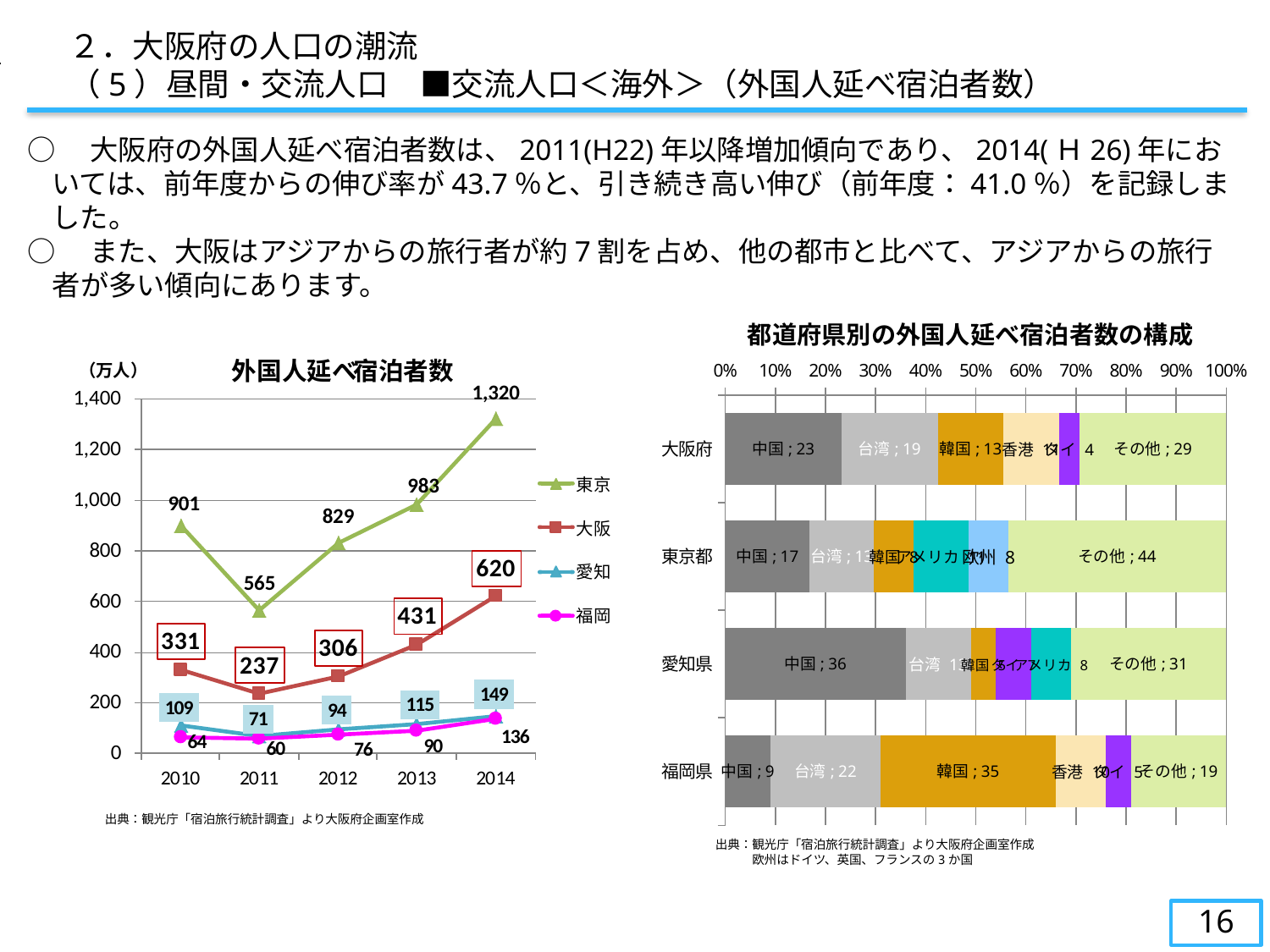
In the chart titled 外国人延べ宿泊者数, how many series does the legend list? 4 In the chart titled 外国人延べ宿泊者数, in which year is the value for 大阪 lowest? 2011 In the chart titled 都道府県別の外国人延べ宿泊者数の構成, how many prefectures are shown? 4 In the chart titled 外国人延べ宿泊者数, what is the value for 福岡 in 2014? 136 In the chart titled 外国人延べ宿泊者数, which is larger in 2012: the value for 愛知 or the value for 福岡? 愛知 In the chart titled 外国人延べ宿泊者数, does the value for 大阪 rise or fall from 2011 to 2014? rise In the chart titled 外国人延べ宿泊者数, what is the value for 大阪 in 2011? 237 What kind of chart is the chart titled 都道府県別の外国人延べ宿泊者数の構成? stacked bar chart In the chart titled 外国人延べ宿泊者数, what is the value for 東京 in 2014? 1,320 In the chart titled 都道府県別の外国人延べ宿泊者数の構成, what is the value for 韓国 in the 福岡県 bar? 35 In the chart titled 外国人延べ宿泊者数, which series has the highest value in 2014? 東京 In the chart titled 外国人延べ宿泊者数, what is the difference between the 大阪 values for 2014 and 2013? 189